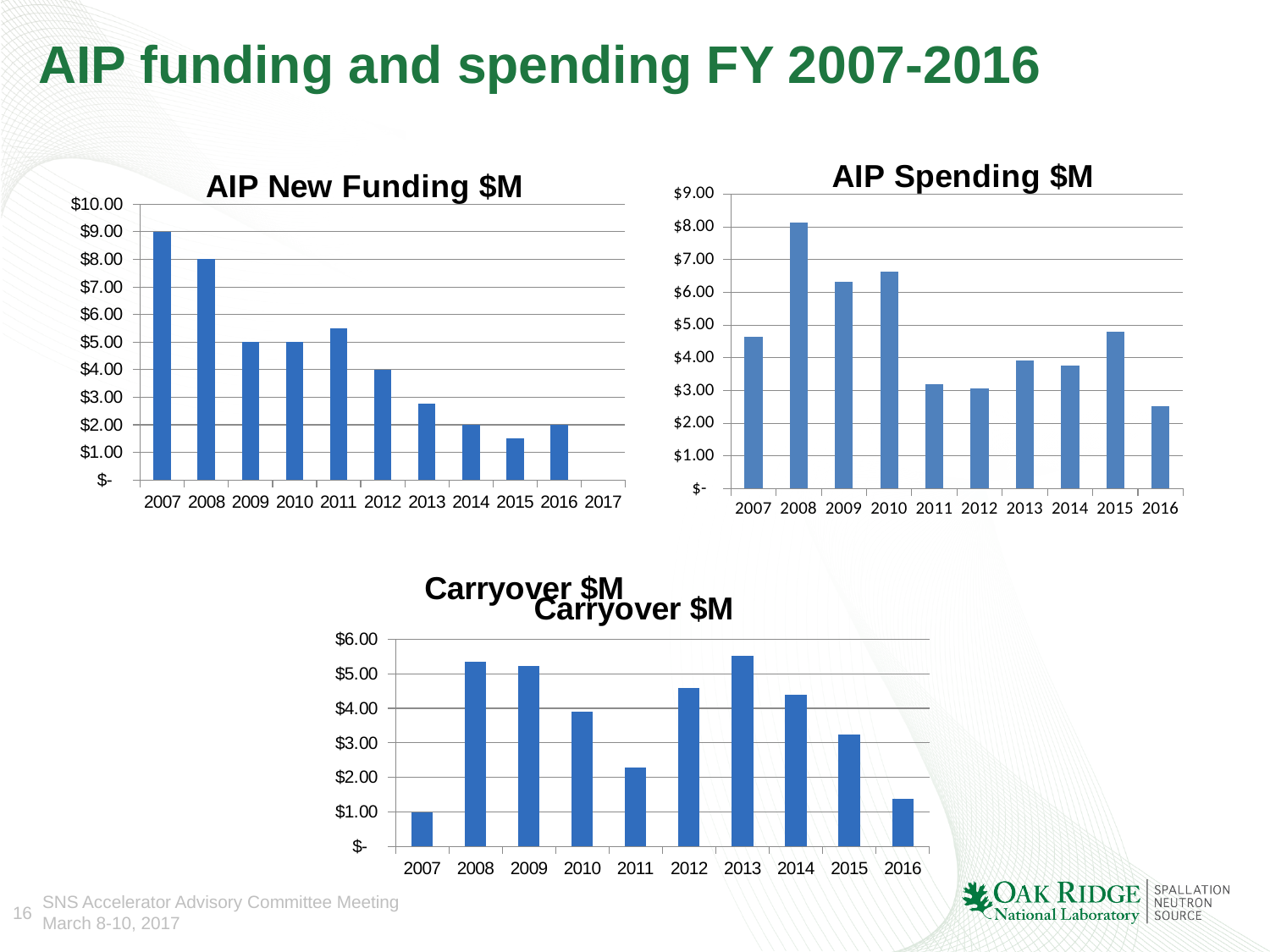
In the AIP New Funding $M chart, do the values generally rise or fall from 2007 to 2016? fall In the Carryover $M chart, how many years are shown on the x axis? 10 In the Carryover $M chart, which year has the highest value? 2013 In the AIP Spending $M chart, which year has the highest value? 2008 In the AIP New Funding $M chart, which year has the highest value? 2007 In the AIP New Funding $M chart, which year has the lowest value? 2015 In the AIP New Funding $M chart, what is the value for 2008? $8.00 In the AIP Spending $M chart, which is larger, the value for 2009 or the value for 2013? 2009 In the AIP Spending $M chart, is the value for 2011 greater or less than $4.00? less In the AIP Spending $M chart, which year has the lowest value? 2016